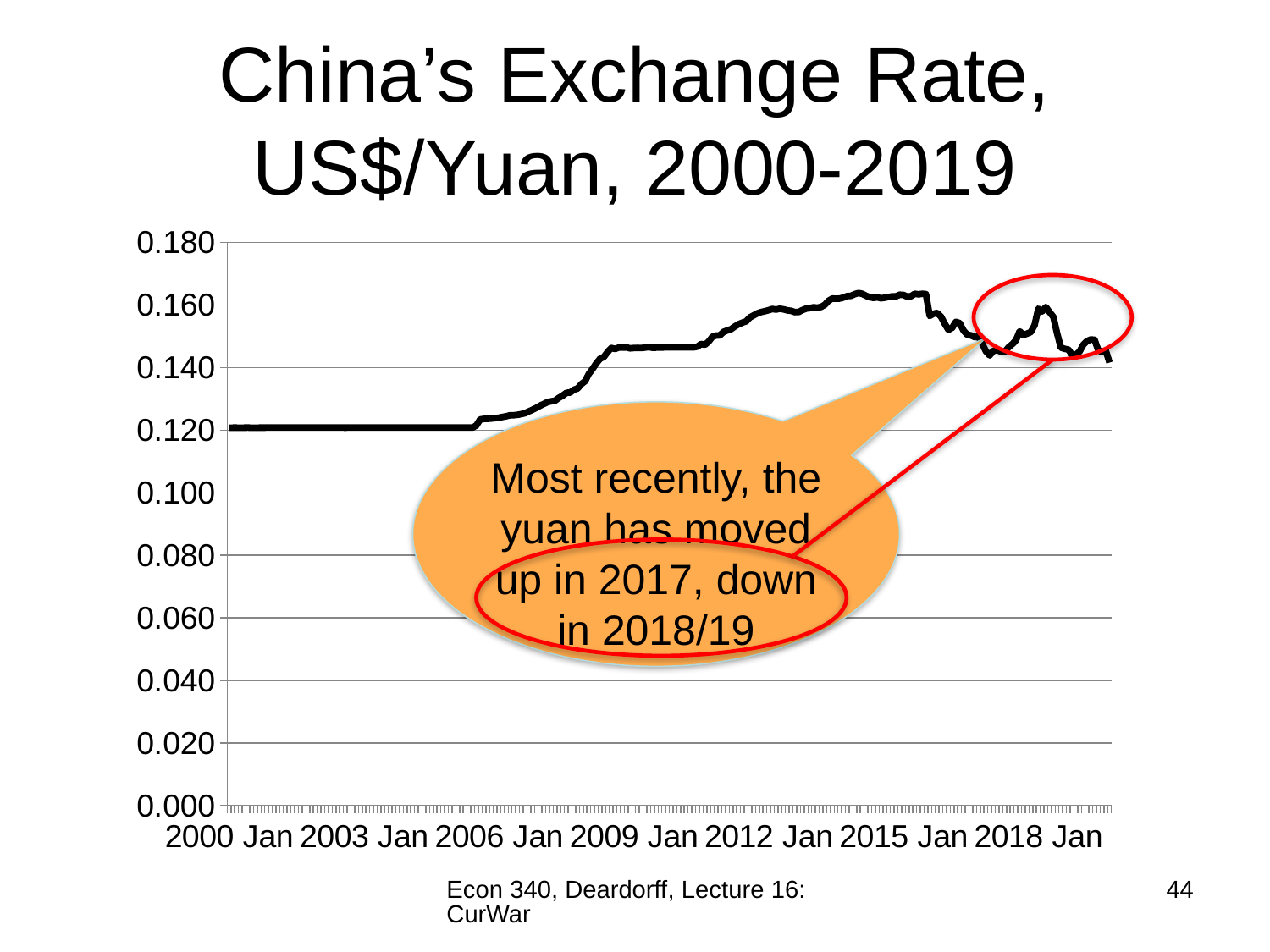
Is the value for 2009 Jan greater or less than 0.120? greater What kind of chart is shown on the slide? line chart What is the title of the chart? China's Exchange Rate, US$/Yuan, 2000-2019 Does the exchange rate generally rise or fall from 2000 Jan to 2015 Jan? rise Which is larger, the value for 2003 Jan or the value for 2015 Jan? 2015 Jan Is the value for 2000 Jan greater or less than 0.140? less Is the value for 2018 Jan greater or less than 0.120? greater How many year labels are shown on the x axis? 7 What is the highest value shown on the y axis? 0.180